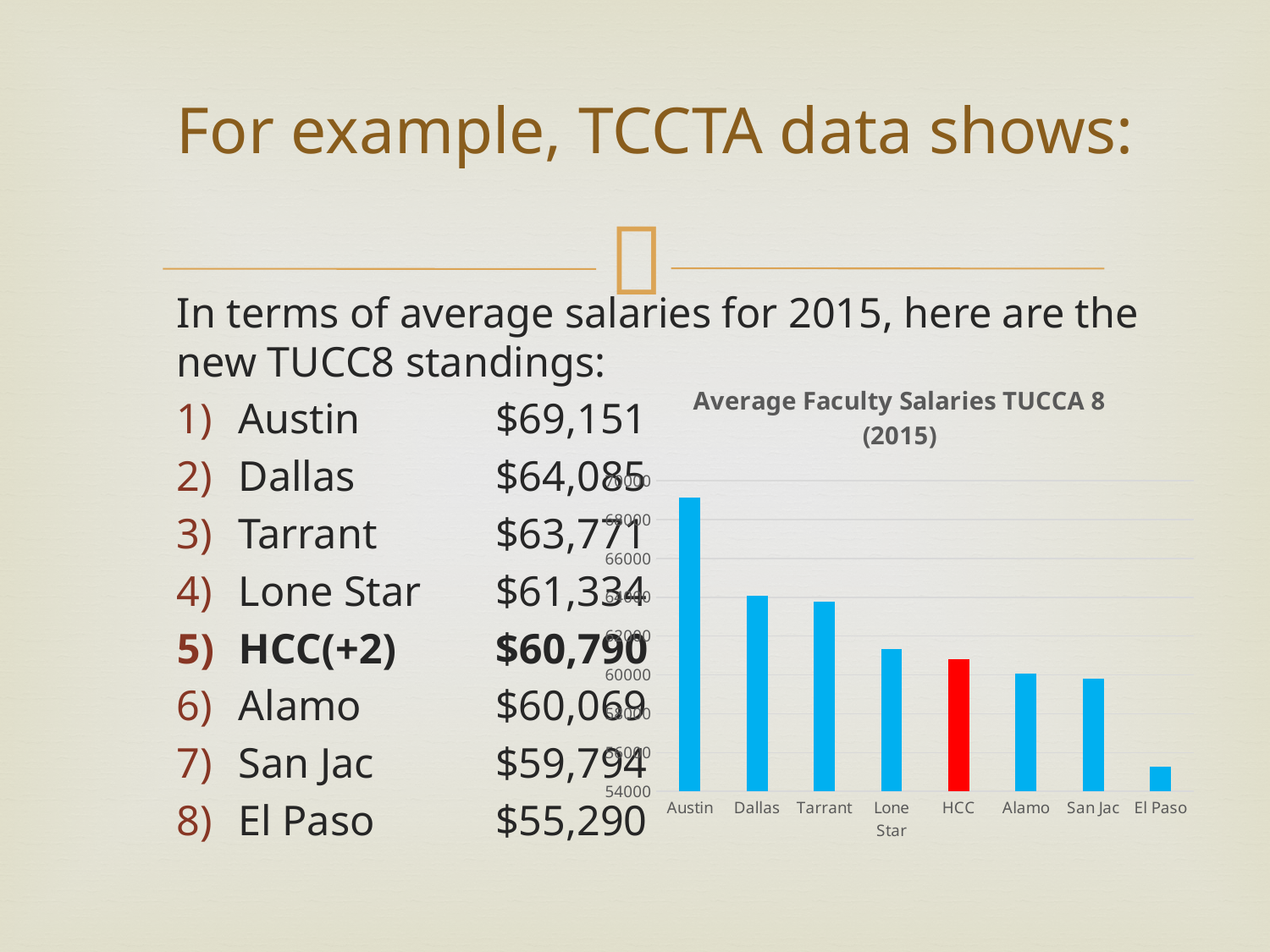
Which college's bar is coloured red in the chart? HCC What is the average faculty salary for HCC? $60,790 Which has a higher average faculty salary, Dallas or Tarrant? Dallas Is the value for Lone Star greater or less than 60000? greater What is the difference between the average faculty salaries of Austin and El Paso? $13,861 What kind of chart is shown on the slide? bar chart Which college has the lowest average faculty salary in the chart? El Paso What is the average faculty salary for Austin? $69,151 Do the bar values rise or fall from left to right across the chart? fall Which college has the highest average faculty salary in the chart? Austin How many colleges are plotted in the Average Faculty Salaries TUCCA 8 (2015) chart? 8 What is the difference between the average faculty salaries of HCC and Alamo? $721